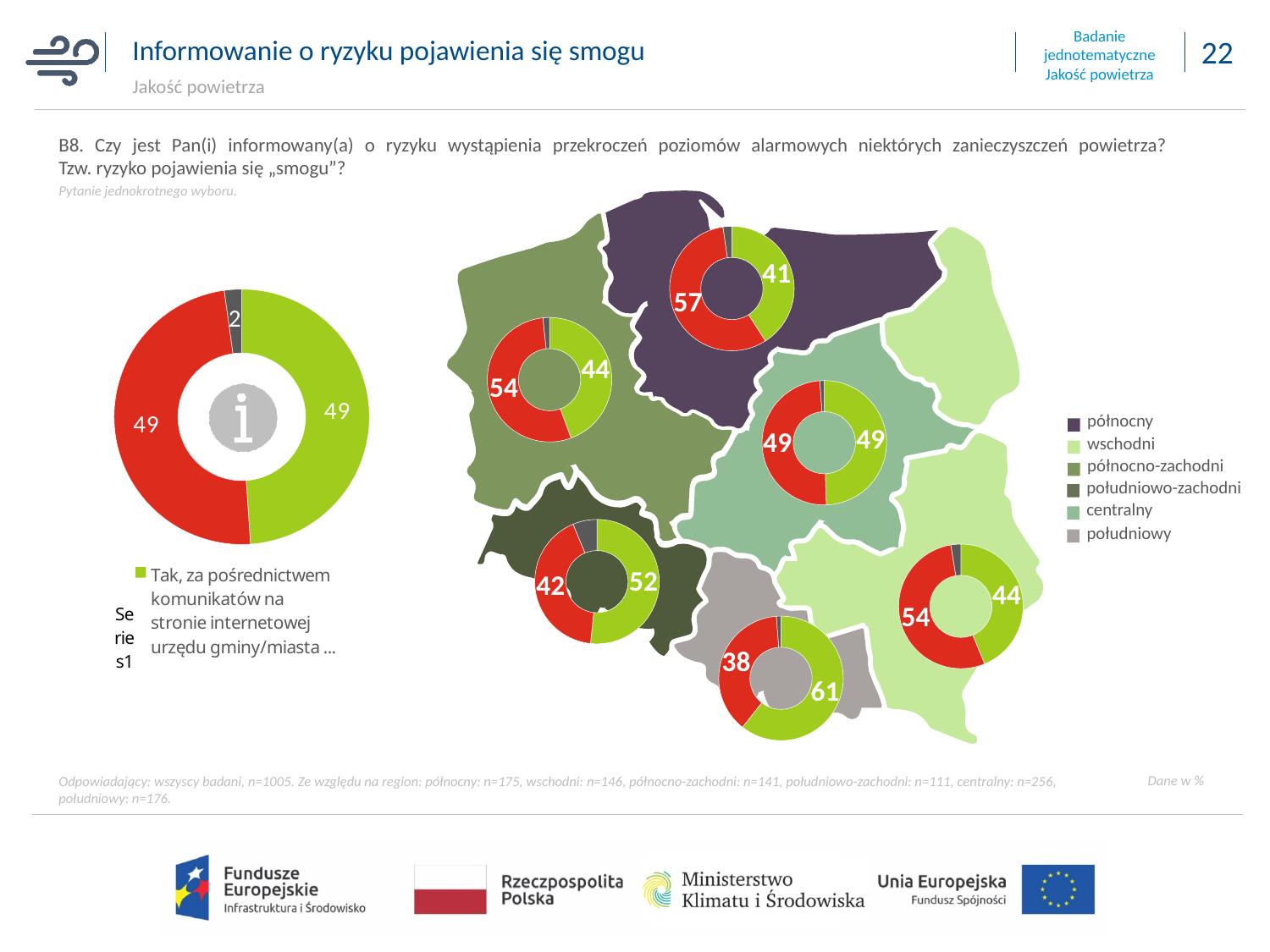
Among the regional donut charts on the map, which region has the highest green-slice value? południowy In the donut chart on the left, what value is shown for the small grey slice? 2 Among the regional donut charts on the map, which region has the lowest green-slice value? północny In the donut chart on the map for the centralny region, what value is shown for the red slice? 49 How many regional donut charts are placed on the map? 6 In the donut chart on the map for the południowy region, what is the difference between the green slice value and the red slice value? 23 In the donut chart on the map for the północny region, which slice has the larger value, the red one or the green one? the red one What kind of chart is the chart on the left of the slide? donut chart In the donut chart on the left, what value is shown for the green slice? 49 How many regions are listed in the map legend on the right? 6 In the donut chart on the map for the południowy region, what value is shown for the green slice? 61 In the donut chart on the map for the północny region, what value is shown for the green slice? 41